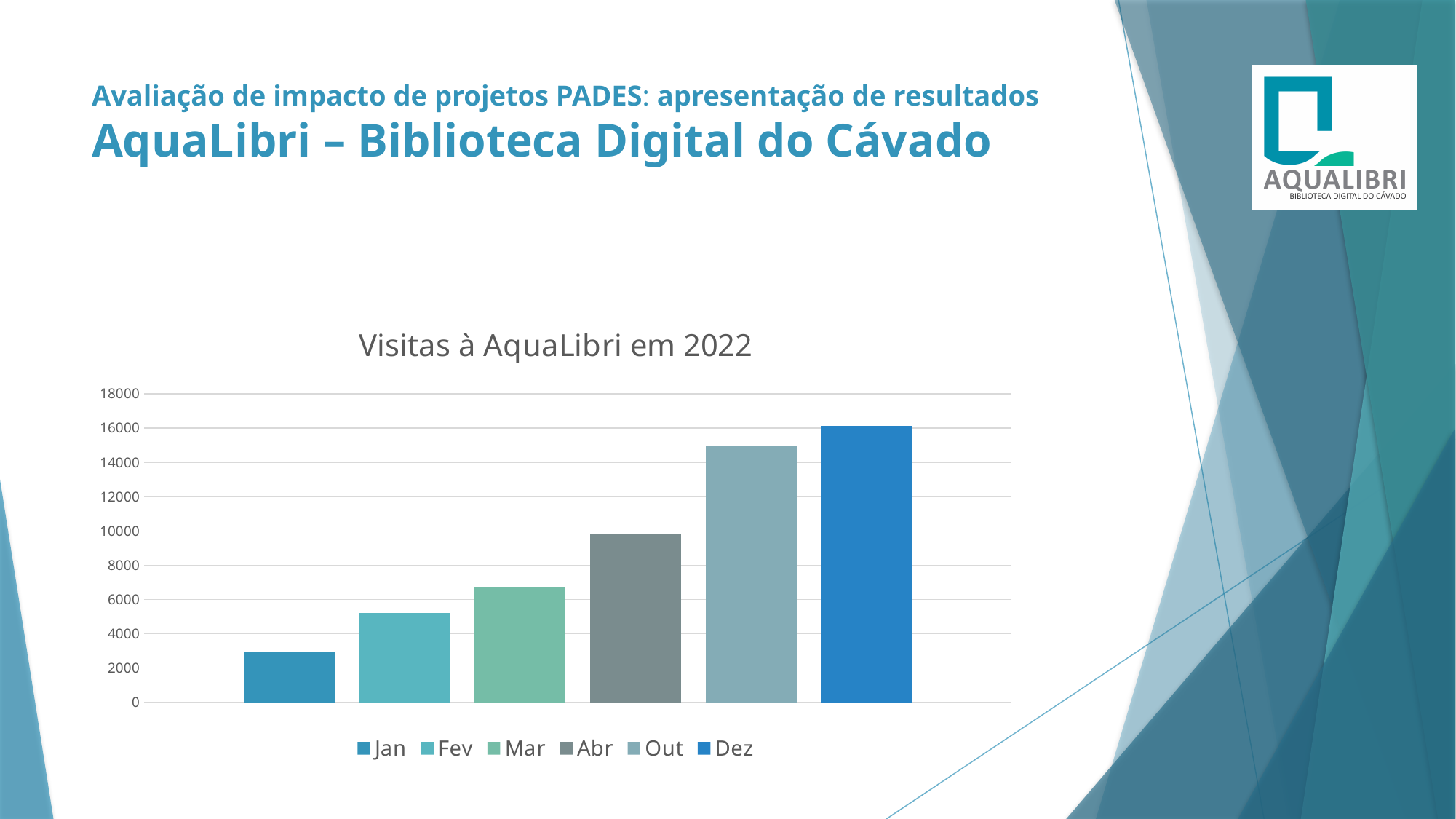
What kind of chart is shown on the slide? bar chart Is the value for Jan greater or less than 4000? less Which has more visits, Mar or Abr? Abr What is the title of the chart? Visitas à AquaLibri em 2022 How many entries does the legend list? 6 How many months are plotted in the chart? 6 Which month has the highest number of visits? Dez Which month has the lowest number of visits? Jan Is the value for Fev greater or less than 4000? greater Is the value for Out greater or less than 14000? greater Do the values rise or fall from Jan to Dez along the x axis? rise